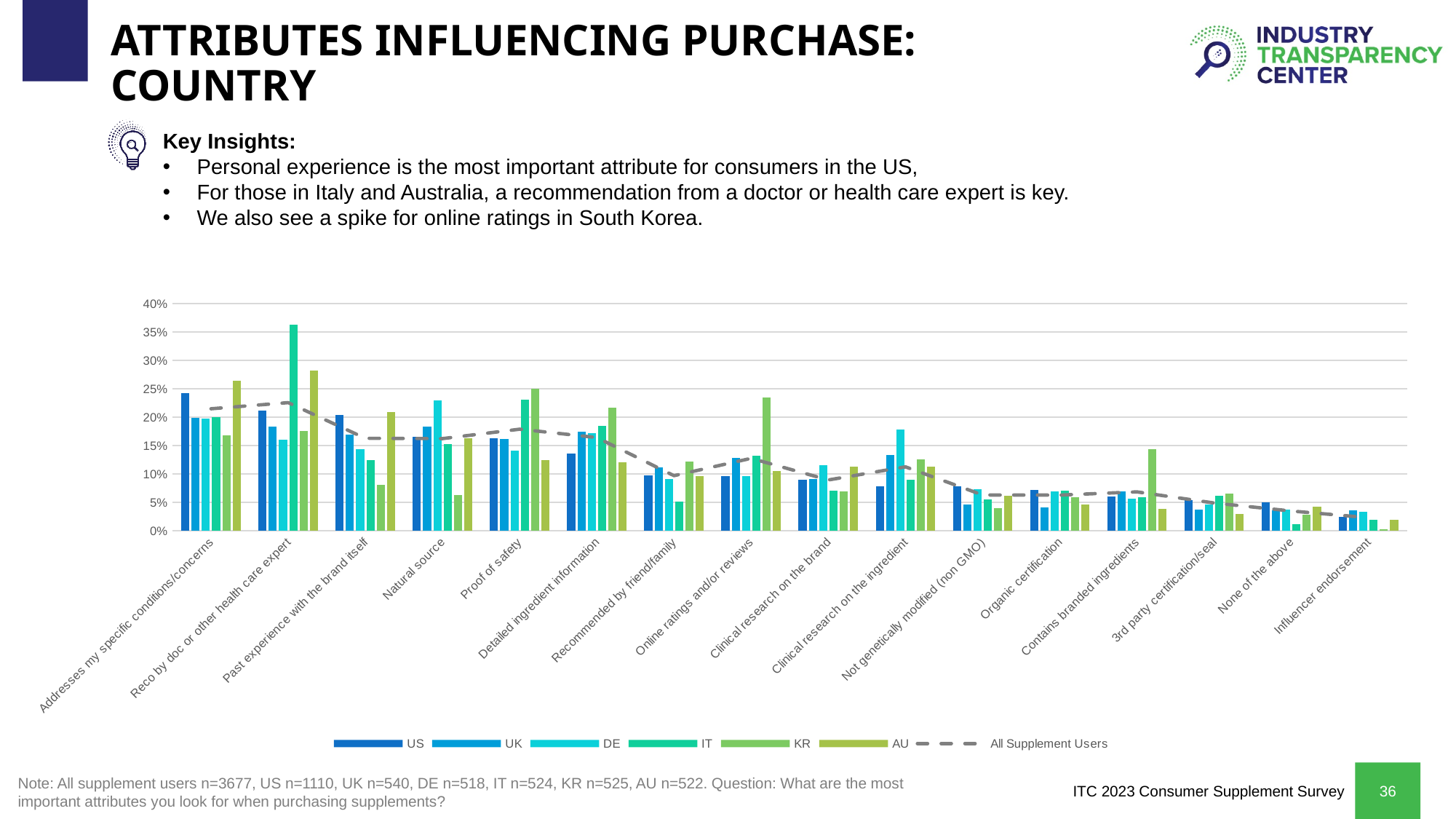
Is the value for KR on 'Online ratings and/or reviews' greater or less than 20%? greater What kind of chart is shown on the slide? combination bar and line chart Which country has the highest bar for 'Online ratings and/or reviews'? KR Is the value for IT on 'Reco by doc or other health care expert' greater or less than 30%? greater Which country has the highest bar for 'Reco by doc or other health care expert'? IT For 'Past experience with the brand itself', which is larger, the US bar or the KR bar? US Is the value for DE on 'Clinical research on the ingredient' greater or less than 15%? greater Which country has the highest bar for 'Contains branded ingredients'? KR What does the dashed grey line in the chart represent? All Supplement Users How many series does the legend list? 7 How many attribute categories are shown on the x axis? 16